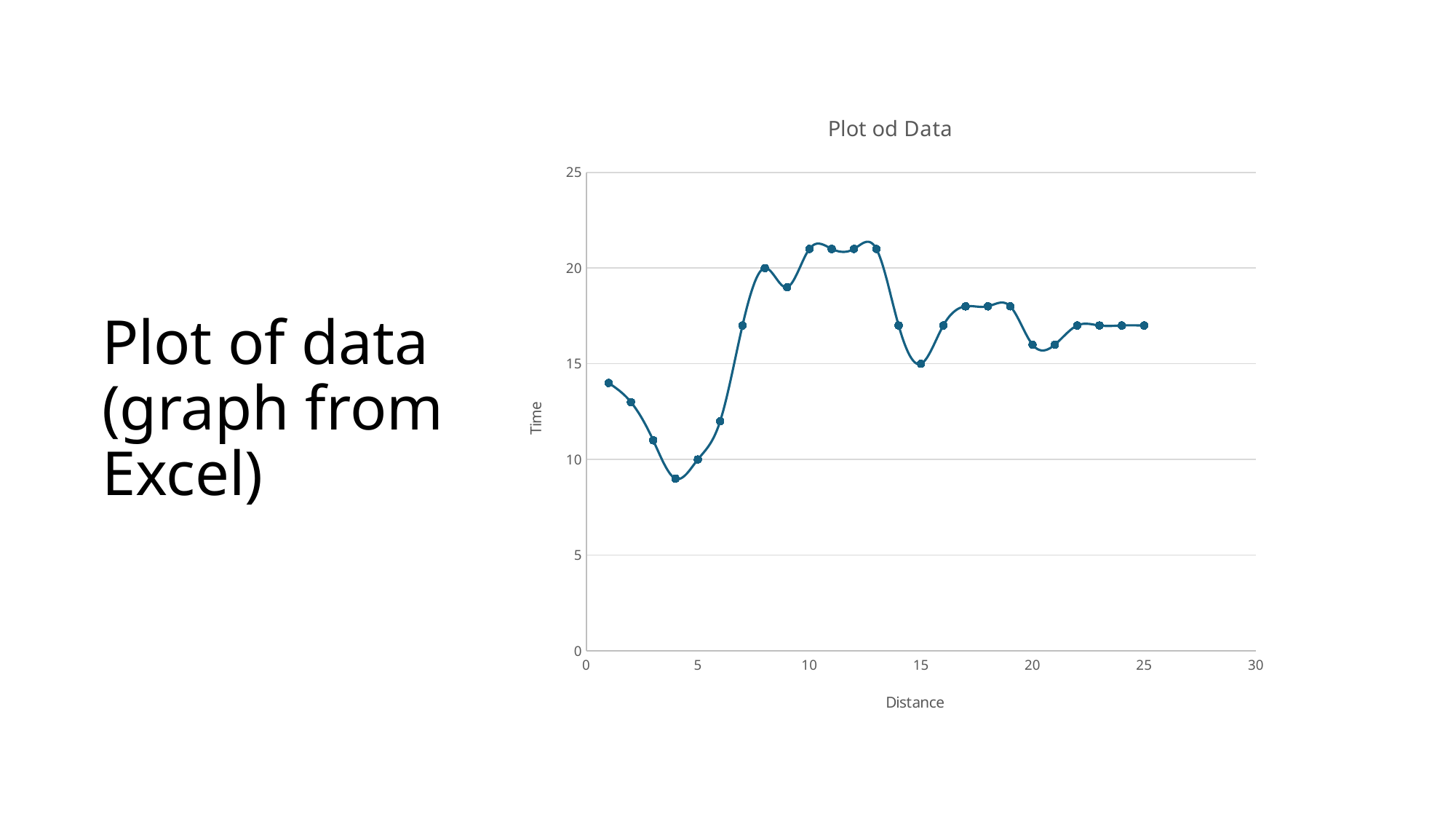
What type of chart is shown on the slide? line chart What is the Time value at Distance 8? 20 What is the title of the chart? Plot od Data Is the Time value at Distance 4 greater or less than 10? less What is the label of the x axis? Distance What is the Time value at Distance 5? 10 What is the Time value at Distance 15? 15 Which is larger, the Time value at Distance 8 or at Distance 15? Distance 8 What is the difference between the Time value at Distance 8 and at Distance 15? 5 Is the Time value at Distance 11 greater or less than 20? greater At which Distance is the Time value lowest? 4 How many data points are plotted on the chart? 25